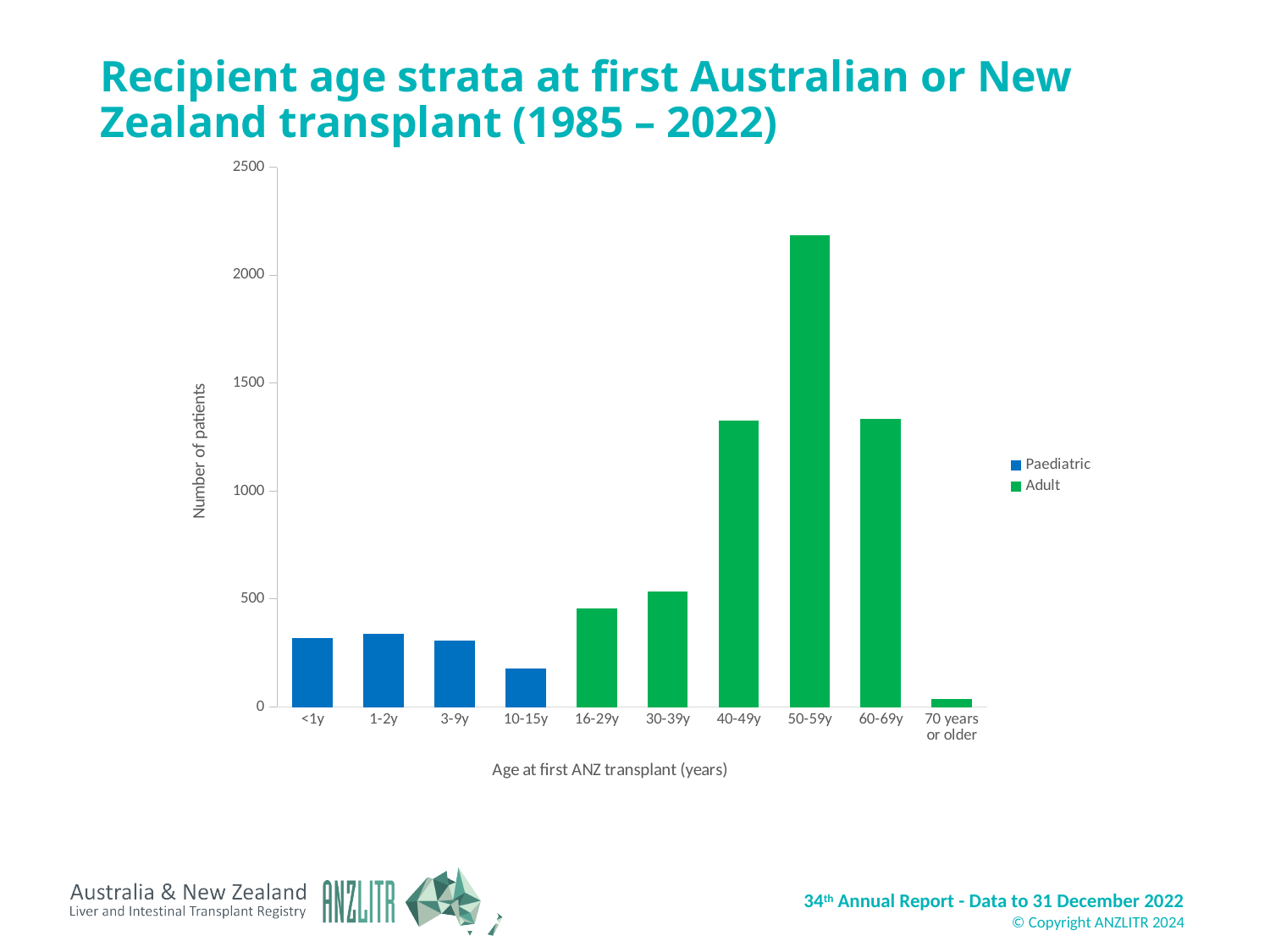
How many series does the legend list? 2 Which age group has the lowest number of patients? 70 years or older Which has more patients, 10-15y or 16-29y? 16-29y Is the number of patients for 16-29y greater or less than 500? less Which series is shown in green in the legend? Adult How many age categories are shown on the x axis? 10 Is the number of patients for 50-59y greater or less than 2000? greater What kind of chart is shown on the slide? Bar chart Is the number of patients for 10-15y greater or less than 500? less Which has more patients, 50-59y or 40-49y? 50-59y Which age group has the highest number of patients? 50-59y